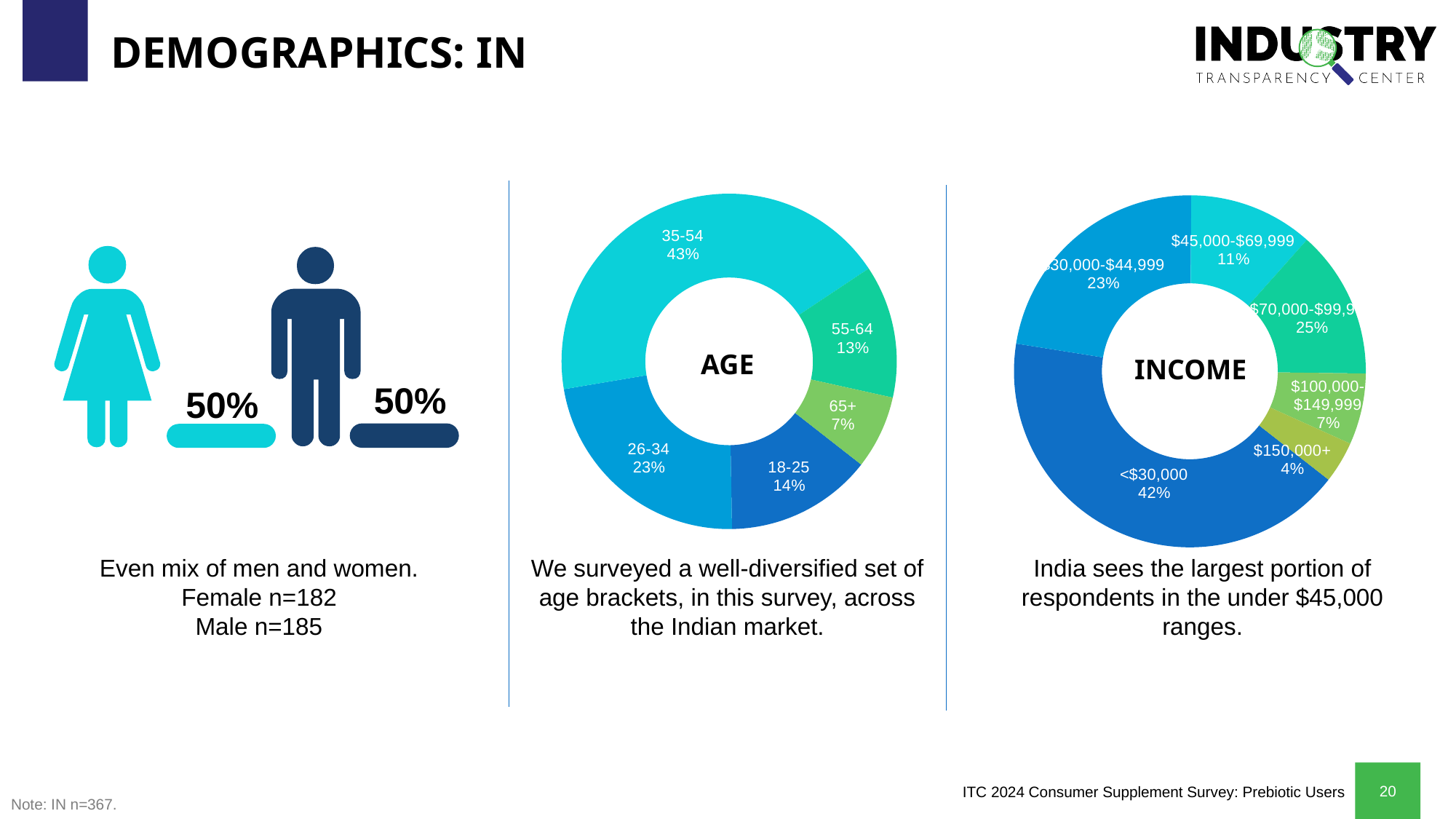
In the AGE chart, what share of respondents are aged 35-54? 43% How many age brackets are shown in the AGE chart? 5 In the AGE chart, what percentage of respondents are in the 18-25 bracket? 14% How many income brackets are shown in the INCOME chart? 6 In the AGE chart, what is the difference in percentage points between the 26-34 and 55-64 brackets? 10 In the AGE chart, which age bracket has the smallest share? 65+ In the INCOME chart, what percentage of respondents are in the $150,000+ bracket? 4% What type of chart is the INCOME chart? Donut chart In the AGE chart, which age bracket has the largest share? 35-54 In the INCOME chart, what share of respondents earn less than $30,000? 42% In the INCOME chart, which income bracket has the largest share? <$30,000 In the INCOME chart, which is larger: the $30,000-$44,999 share or the $45,000-$69,999 share? $30,000-$44,999